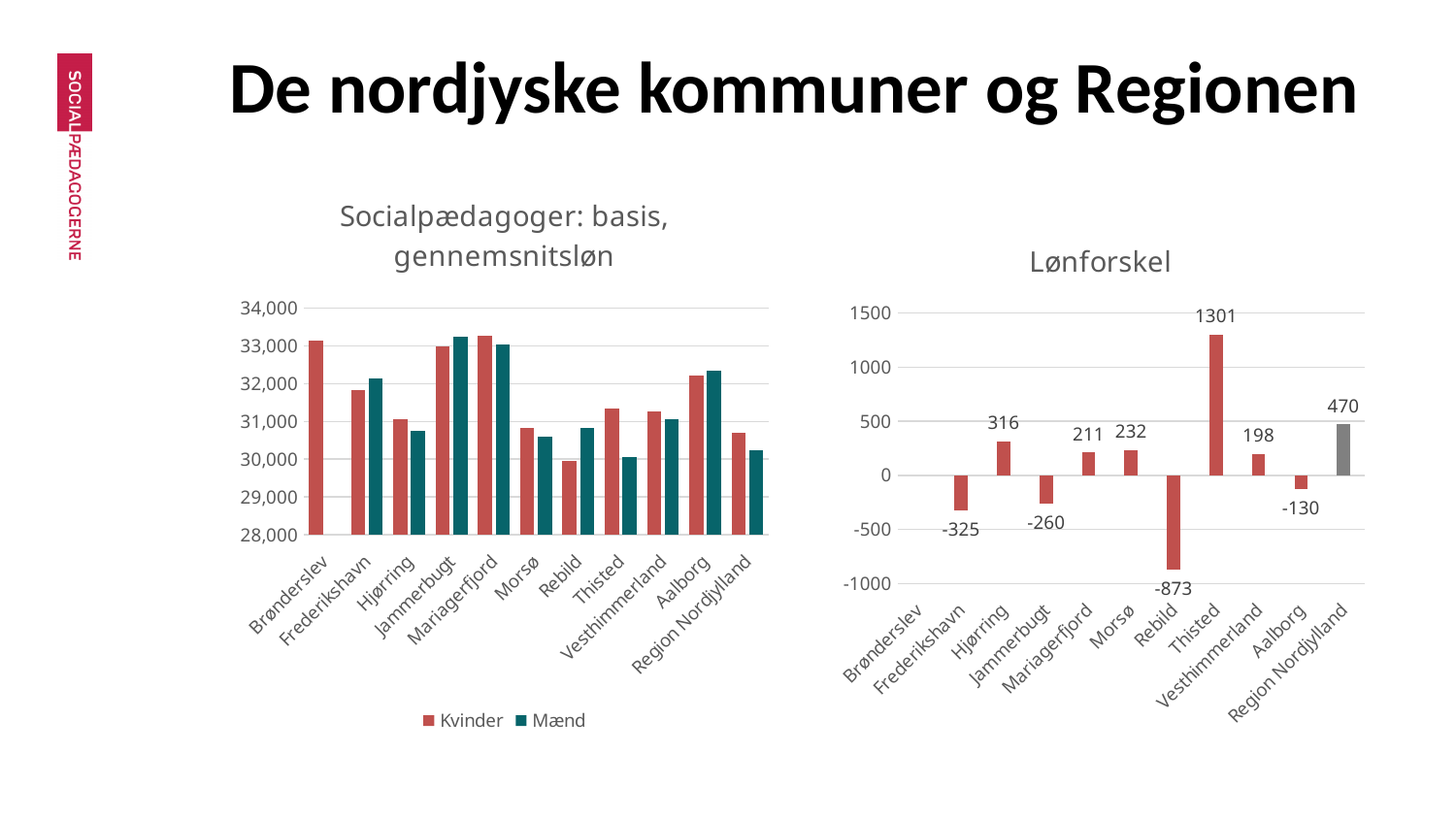
In the chart titled 'Socialpædagoger: basis, gennemsnitsløn', how many series does the legend list? 2 In the Lønforskel chart, what is the value for Thisted? 1301 In the Lønforskel chart, which category has the lowest value? Rebild In the chart titled 'Socialpædagoger: basis, gennemsnitsløn', is the Kvinder value for Brønderslev greater or less than 33,000? greater In the Lønforskel chart, which is larger, the value for Hjørring or the value for Morsø? Hjørring In the Lønforskel chart, how many categories are labelled on the x axis? 11 In the chart titled 'Socialpædagoger: basis, gennemsnitsløn', is the Mænd value for Hjørring greater or less than 31,000? less What kind of chart is the chart titled 'Socialpædagoger: basis, gennemsnitsløn'? bar chart In the Lønforskel chart, what is the difference between the values for Morsø and Mariagerfjord? 21 In the Lønforskel chart, what is the value for Rebild? -873 In the Lønforskel chart, what is the value for Region Nordjylland? 470 In the Lønforskel chart, which category has the highest value? Thisted